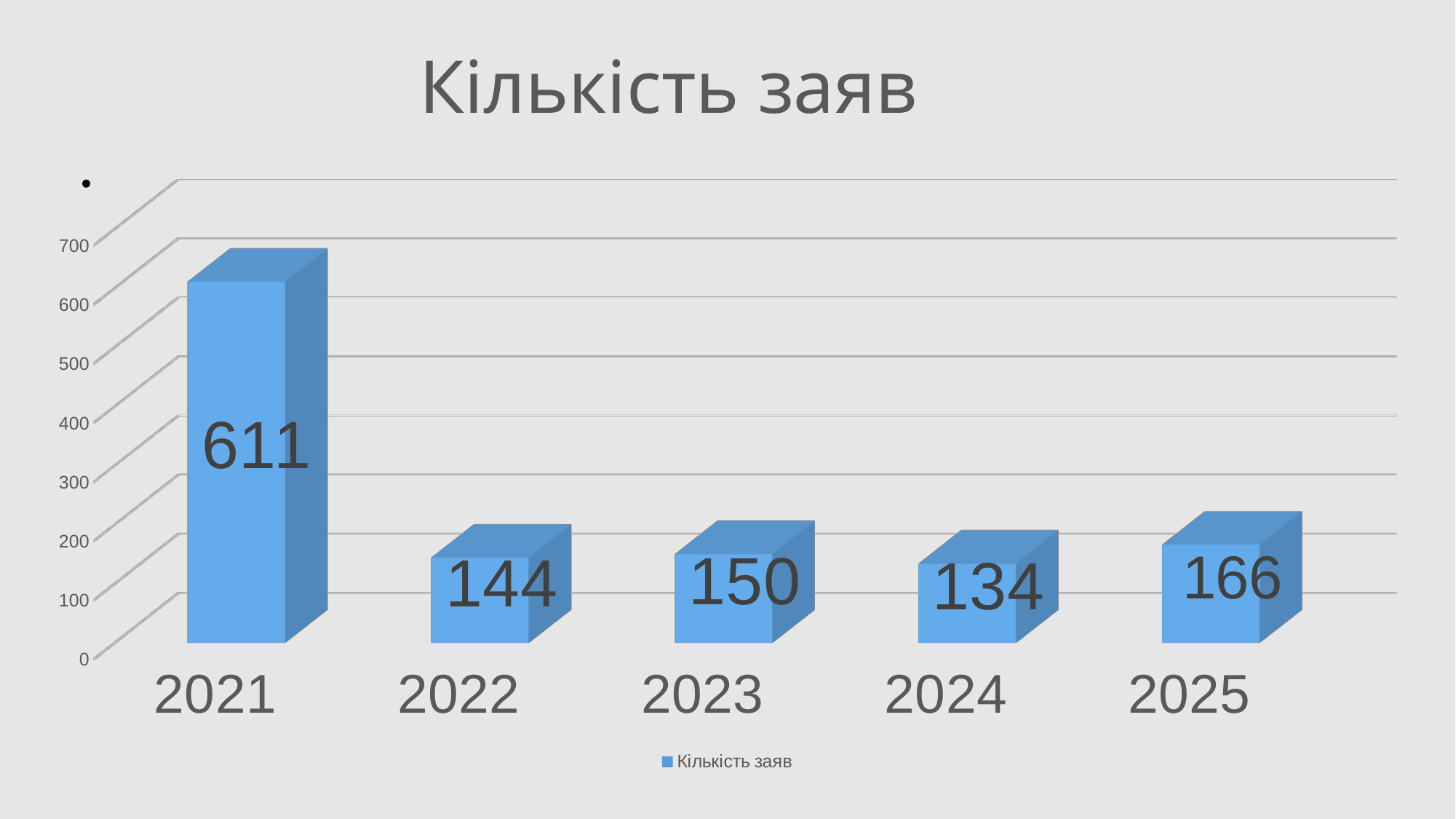
What is the title of the chart? Кількість заяв What is the value for 2025? 166 Is the value for 2022 greater or less than 200? less Which is larger, the value for 2023 or the value for 2024? 2023 Which year has the highest value? 2021 Which year has the lowest value? 2024 How many years are shown on the x axis? 5 What kind of chart is shown on the slide? bar chart What is the difference between the values for 2025 and 2023? 16 What is the difference between the values for 2021 and 2022? 467 What is the value for 2021? 611 What is the value for 2024? 134